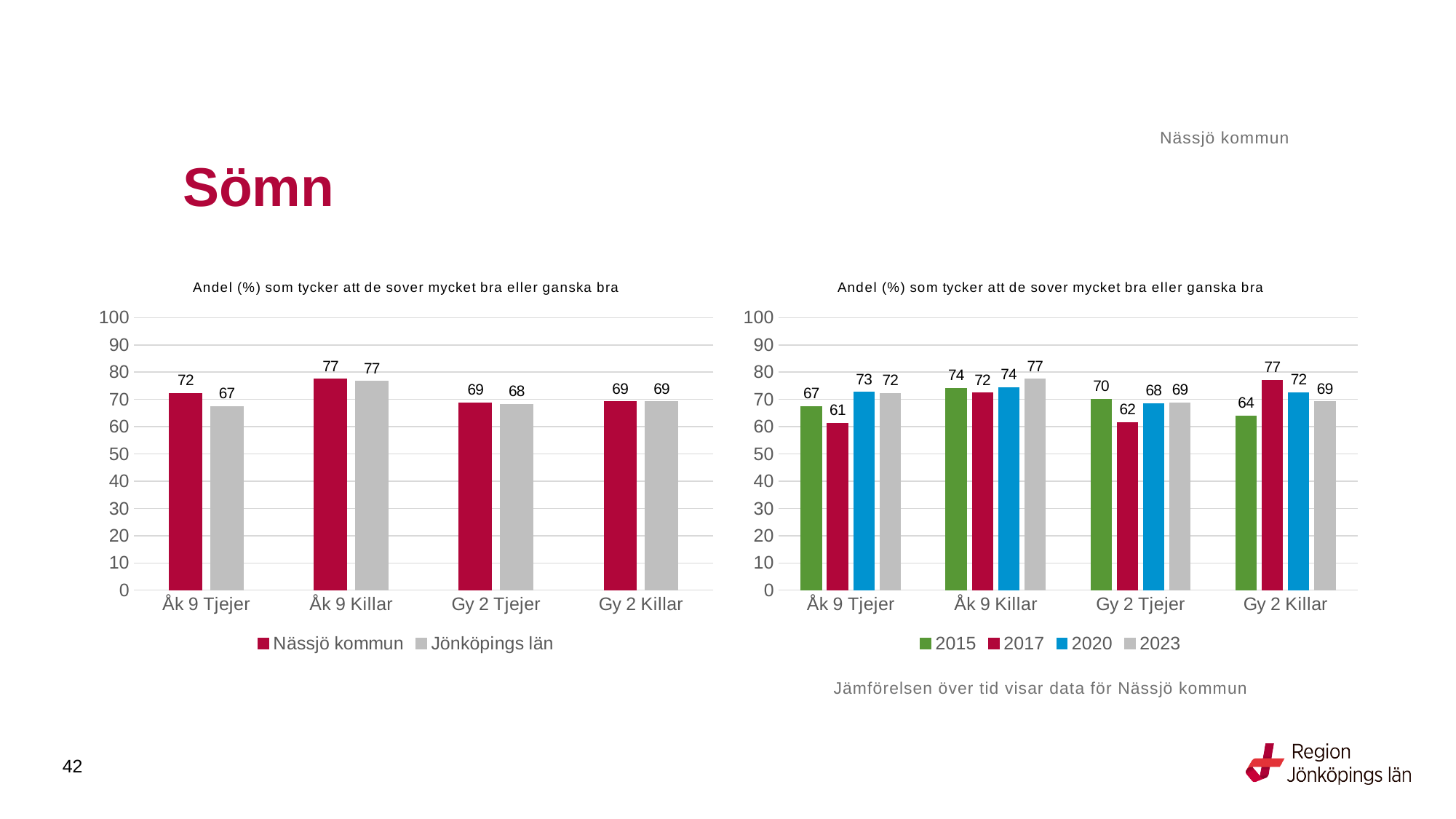
In the right chart, which is larger for Gy 2 Killar: the value for 2015 or the value for 2017? 2017 In the left chart, how many series does the legend list? 2 In the right chart, how many series does the legend list? 4 In the left chart, which category has the highest value for Nässjö kommun? Åk 9 Killar In the left chart, what is the value for Jönköpings län for Gy 2 Tjejer? 68 In the right chart, what is the value for 2020 for Gy 2 Killar? 72 In the right chart, what is the difference between the 2023 and 2015 values for Åk 9 Tjejer? 5 In the right chart, what is the value for 2017 for Åk 9 Tjejer? 61 In the right chart, which year has the lowest value for Gy 2 Tjejer? 2017 In the left chart, what is the value for Nässjö kommun for Åk 9 Tjejer? 72 In the left chart, what is the difference between Nässjö kommun and Jönköpings län for Åk 9 Tjejer? 5 What kind of chart is the left chart? Bar chart